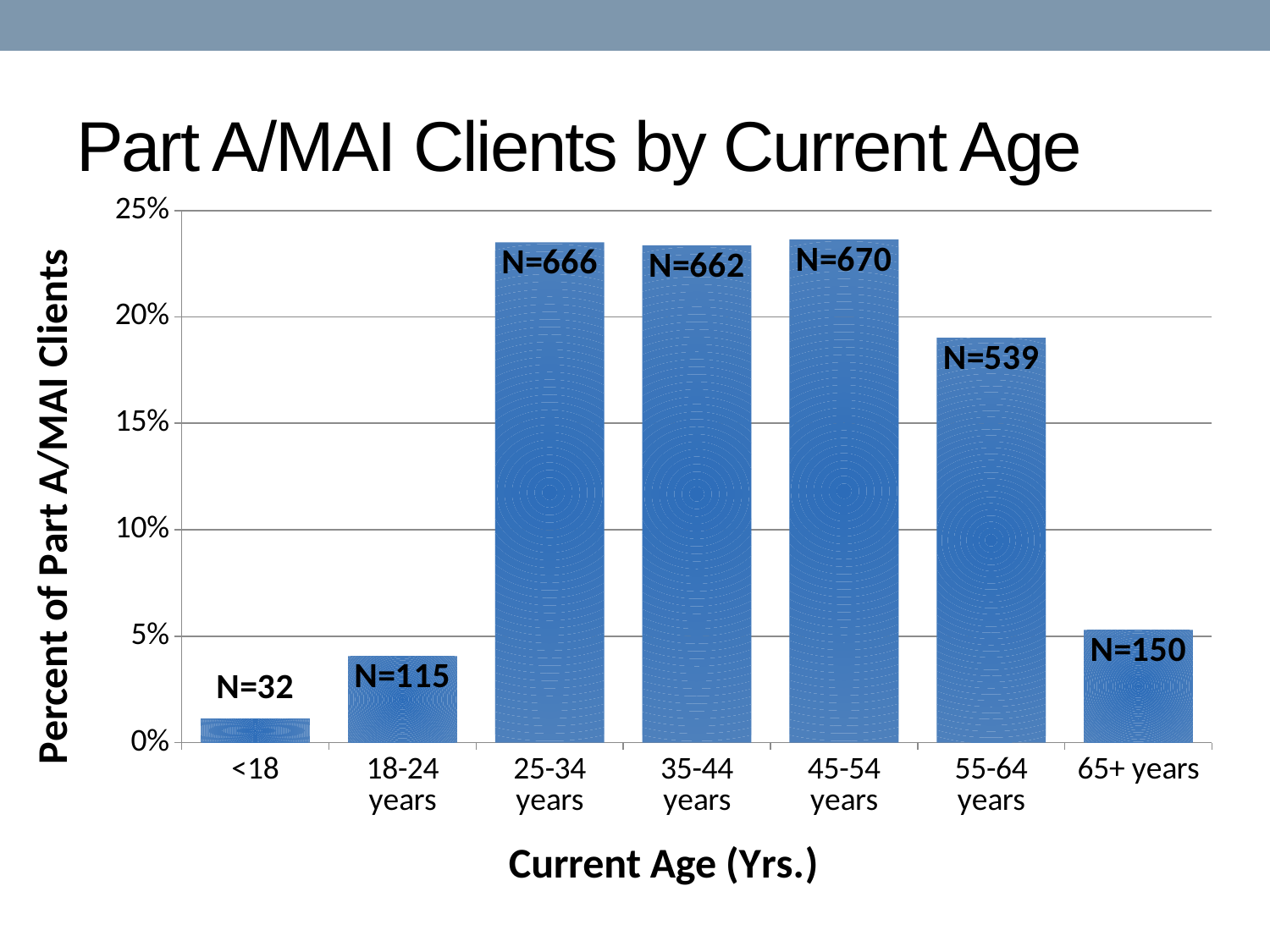
What is the N value shown for the 55-64 years age group? N=539 Is the percent of clients for the 55-64 years group greater or less than 15%? greater What is the N value shown for the 65+ years age group? N=150 What is the difference between the N values for the 45-54 years and 55-64 years groups? 131 What is the N value shown for the 25-34 years age group? N=666 What is the title of the chart? Part A/MAI Clients by Current Age What type of chart is shown on the slide? bar chart Which age group has the lowest percent of Part A/MAI clients? <18 What is the N value shown for the <18 age group? N=32 How many age groups are shown on the x axis? 7 Which has a larger percent of clients, the 55-64 years group or the 65+ years group? 55-64 years Is the percent of clients for the 18-24 years group greater or less than 5%? less